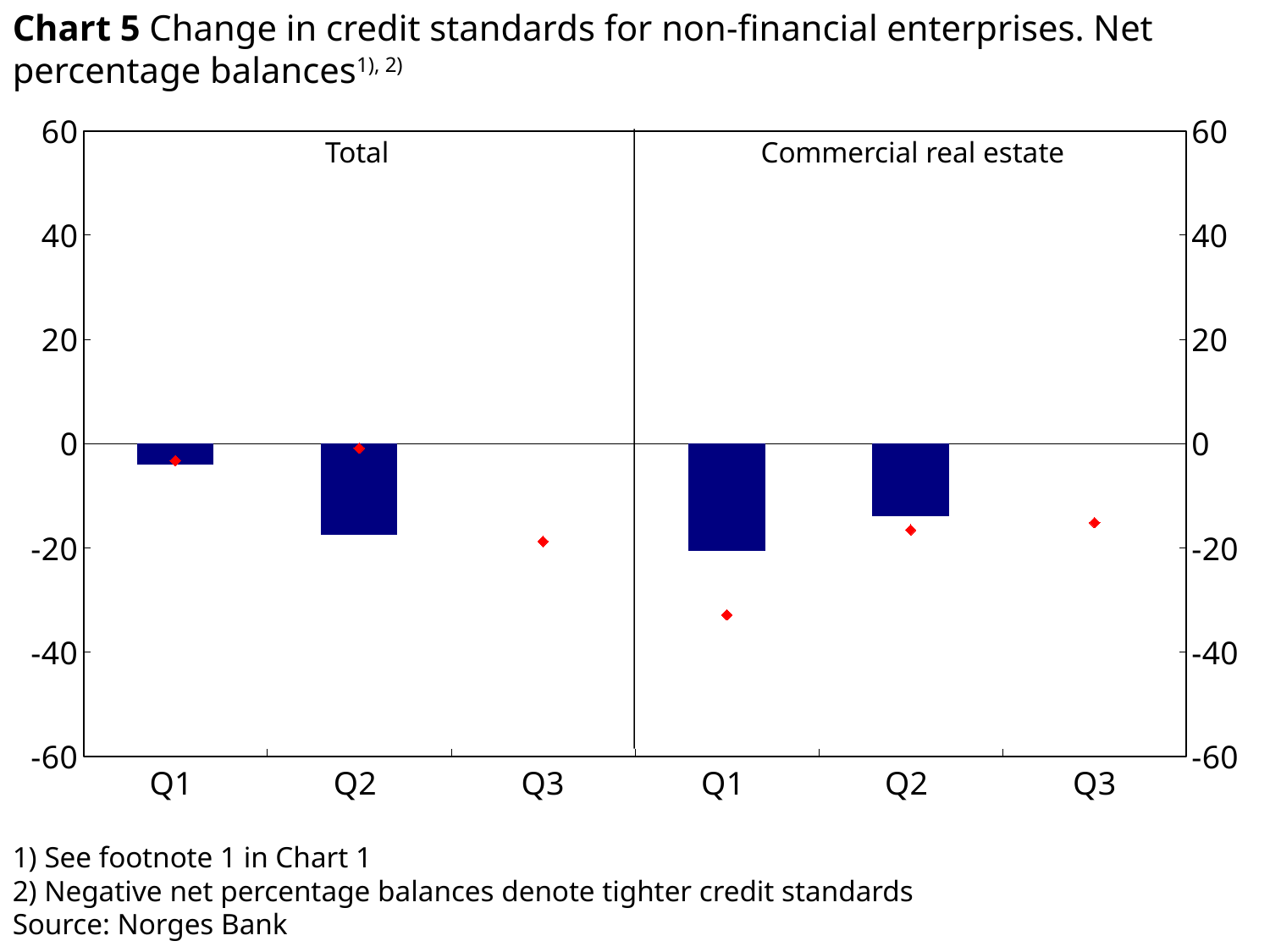
How many quarters are labelled on the x axis of the Total panel? 3 In the Total panel, is the bar for Q1 greater or less than -20? greater How many bars are plotted in the chart in total across both panels? 4 What are the two panels of the chart labelled? Total and Commercial real estate In the Commercial real estate panel, which quarter has the lowest bar? Q1 In the Total panel, which quarter has the lowest bar? Q2 What kind of chart is shown on the slide? bar chart In the Commercial real estate panel, is the bar for Q2 greater or less than -20? greater What is the source given for the chart? Norges Bank In the Commercial real estate panel, is the red diamond for Q1 greater or less than -20? less